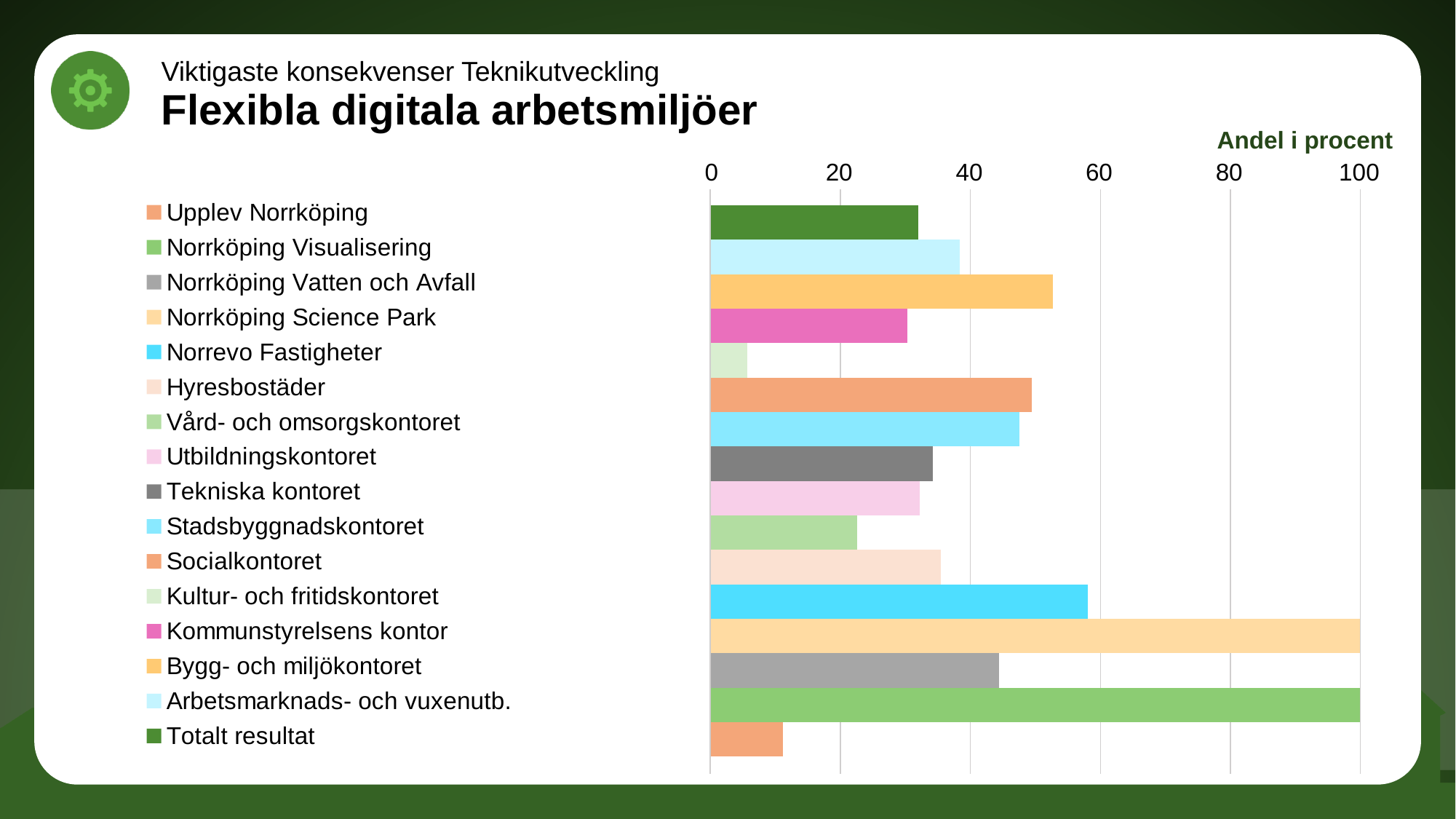
Is the value for Norrevo Fastigheter greater or less than 40? greater How many entries does the legend list? 16 What is the value for Norrköping Visualisering? 100 What is the value for Norrköping Science Park? 100 What is the main title of the slide? Flexibla digitala arbetsmiljöer Is the value for Upplev Norrköping greater or less than 20? less Is the value for Bygg- och miljökontoret greater or less than 60? less What kind of chart is shown on the slide? bar chart What is the label shown above the horizontal axis? Andel i procent Which is larger, the value for Socialkontoret or the value for Vård- och omsorgskontoret? Socialkontoret How many bars are plotted in the chart? 16 Which category has the lowest value? Kultur- och fritidskontoret